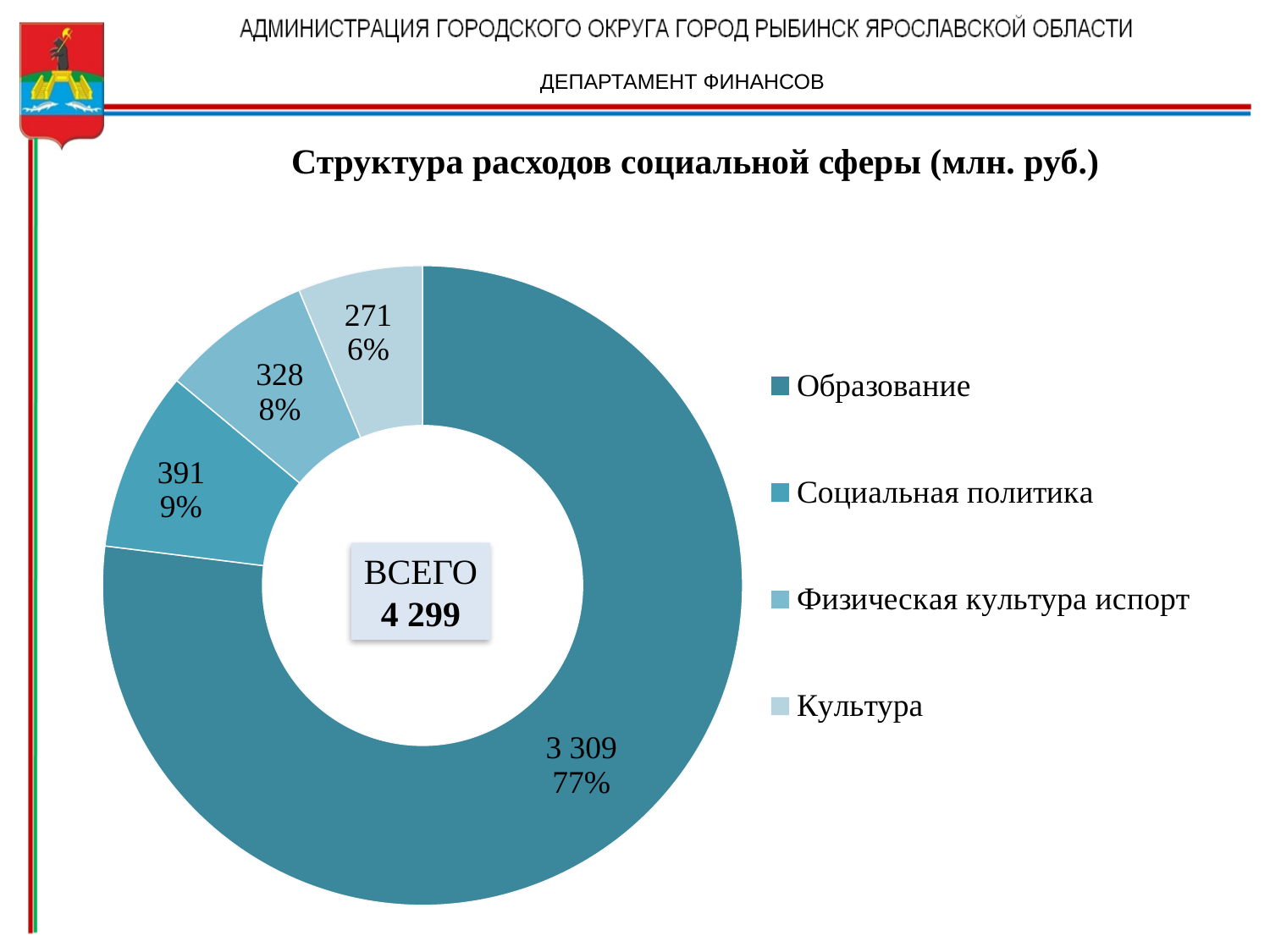
Which is larger, the value for Физическая культура и спорт or the value for Культура? Физическая культура и спорт What is the value for Физическая культура и спорт? 328 What is the value for Социальная политика? 391 What share of the chart does Социальная политика represent? 9% What kind of chart is shown on the slide? Pie chart (doughnut) What is the value for Образование? 3 309 What share of the chart does Образование represent? 77% What is the value for Культура? 271 What is the difference between the values for Социальная политика and Культура? 120 Which category has the smallest share of the chart? Культура How many categories does the chart show? 4 Which category has the largest share of the chart? Образование